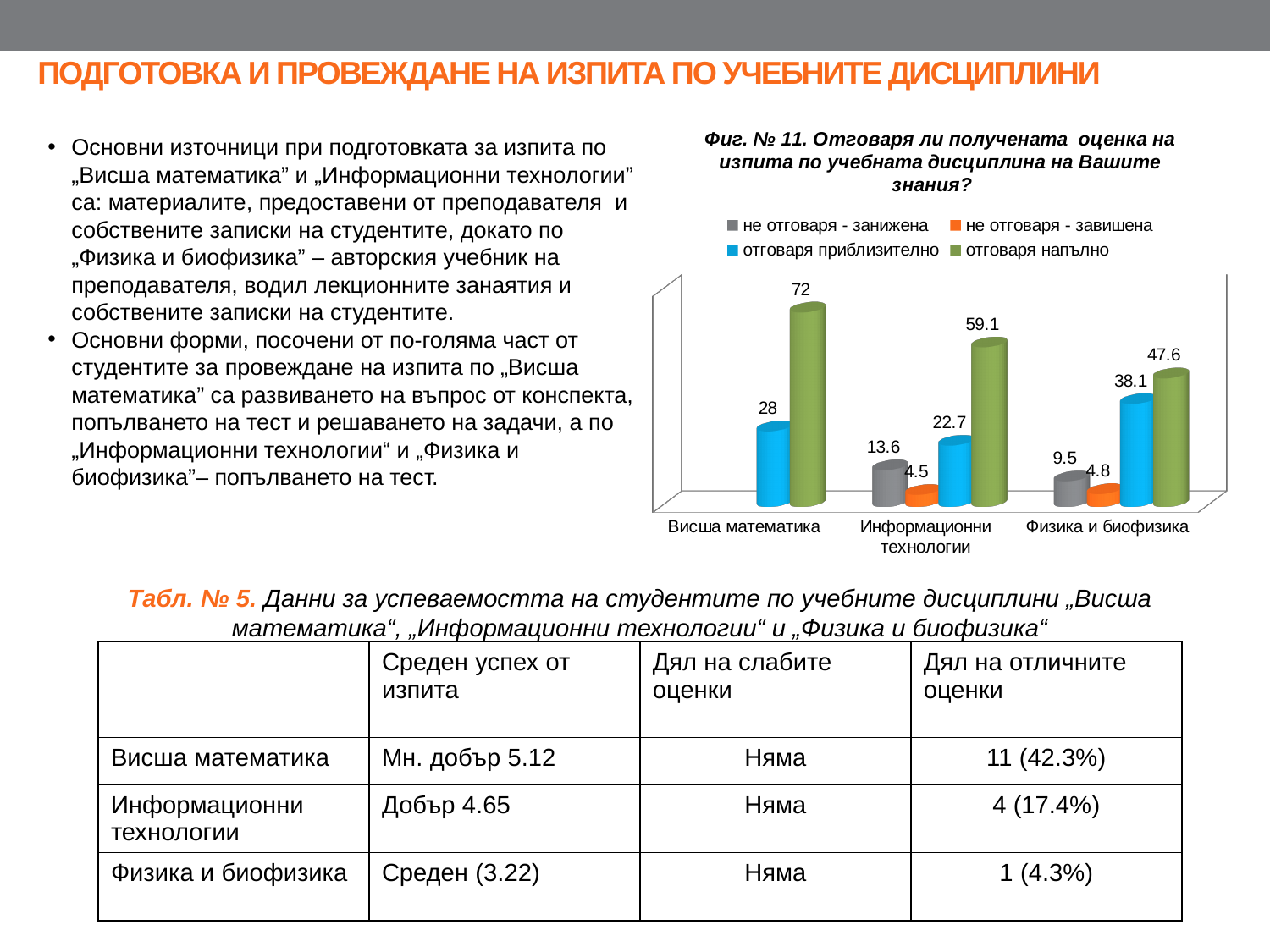
In Fig. № 11, what is the difference between "отговаря напълно" and "отговаря приблизително" for Физика и биофизика? 9.5 How many categories are shown on the x axis of Fig. № 11? 3 In Fig. № 11, which colour represents the series "отговаря напълно"? green In Fig. № 11, which is larger for Информационни технологии: "не отговаря - занижена" or "не отговаря - завишена"? не отговаря - занижена In Fig. № 11, what is the value of "отговаря напълно" for Висша математика? 72 In Fig. № 11, what is the value of "отговаря приблизително" for Информационни технологии? 22.7 In Fig. № 11, which category has the lowest value for "отговаря приблизително"? Информационни технологии In Fig. № 11, what is the value of "не отговаря - занижена" for Физика и биофизика? 9.5 What type of chart is shown in Fig. № 11? bar chart In Fig. № 11, what is the difference between "отговаря напълно" for Висша математика and for Информационни технологии? 12.9 In Fig. № 11, which category has the highest value for "отговаря напълно"? Висша математика How many series does the legend of Fig. № 11 list? 4